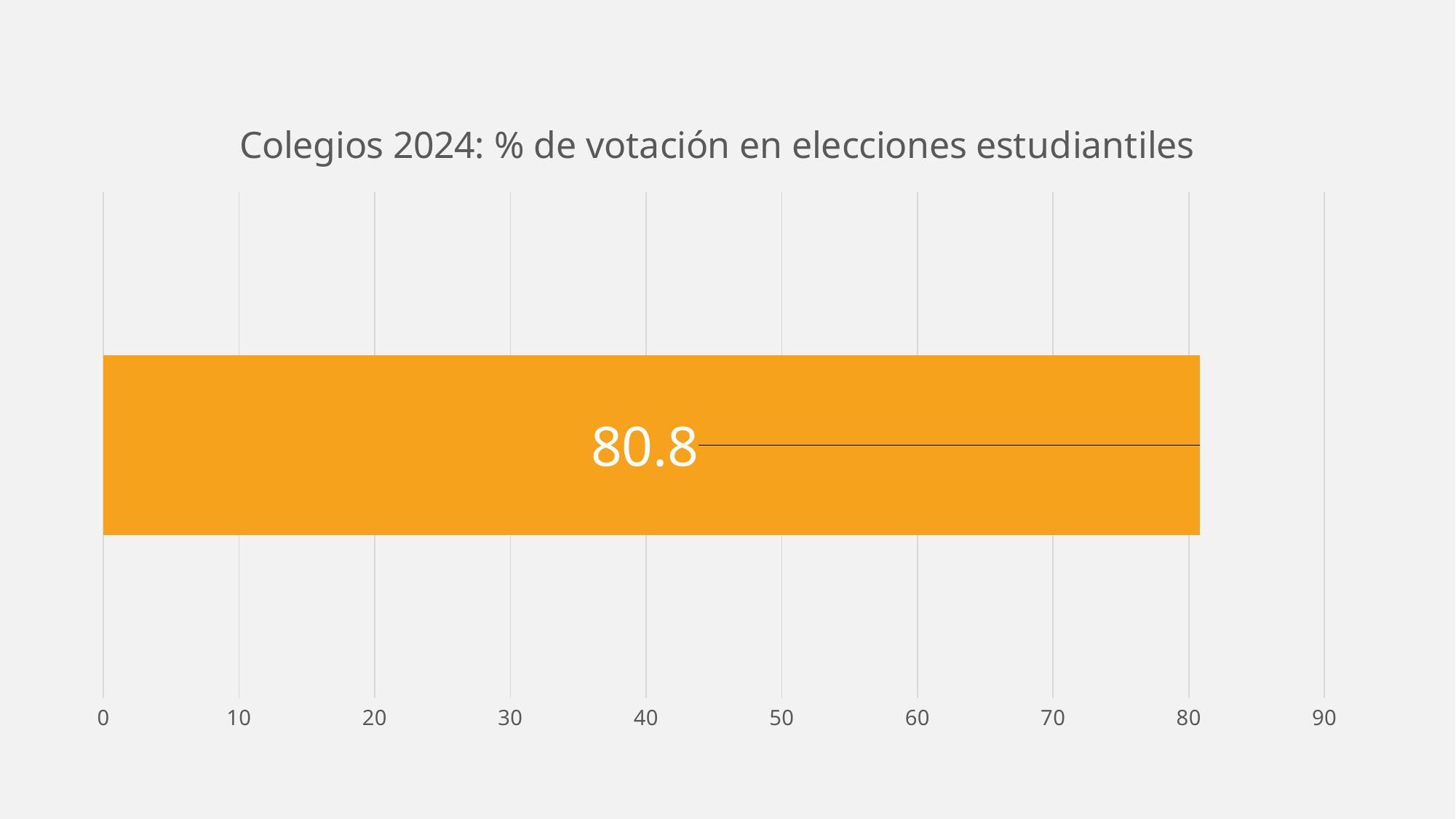
How many bars are plotted in the chart? 1 What colour is the bar in the chart? orange Is the value of the bar greater or less than 70? greater What kind of chart is shown on the slide? bar chart What value is printed on the bar in the chart? 80.8 What is the title of the chart? Colegios 2024: % de votación en elecciones estudiantiles Is the value of the bar greater or less than 90? less What is the highest tick value shown on the horizontal axis? 90